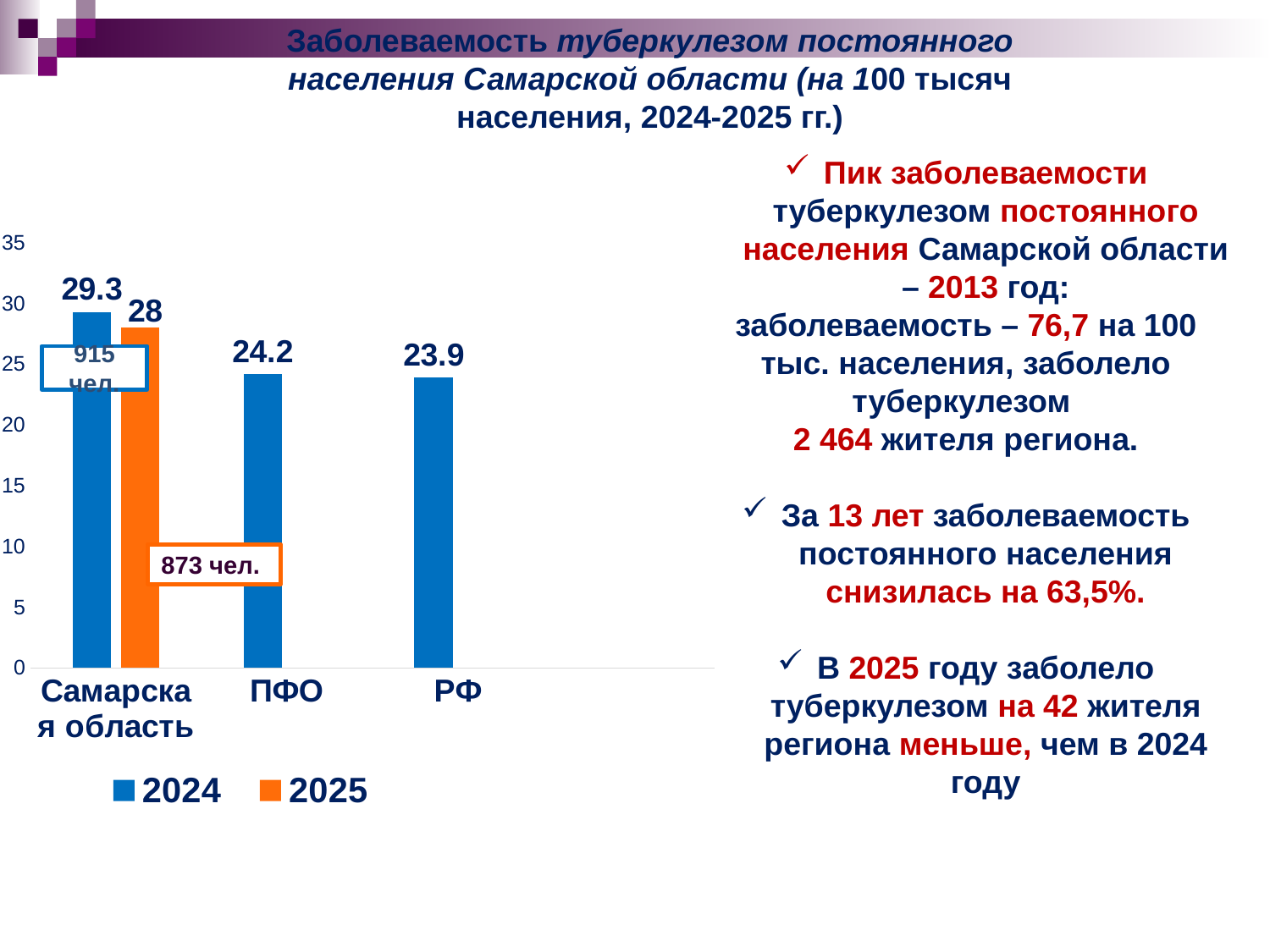
What is the 2024 value for ПФО? 24.2 Which is larger: the 2024 value for Самарская область or the 2024 value for ПФО? Самарская область What is the 2024 value for Самарская область? 29.3 Which category has the lowest 2024 value? РФ What is the 2024 value for РФ? 23.9 What is the 2025 value for Самарская область? 28 How many categories are shown on the x axis? 3 What type of chart is shown on the slide? Bar chart How many series does the legend list? 2 What is the difference between the 2024 values for ПФО and РФ? 0.3 What is the difference between the 2024 and 2025 values for Самарская область? 1.3 Which category has the highest 2024 value? Самарская область